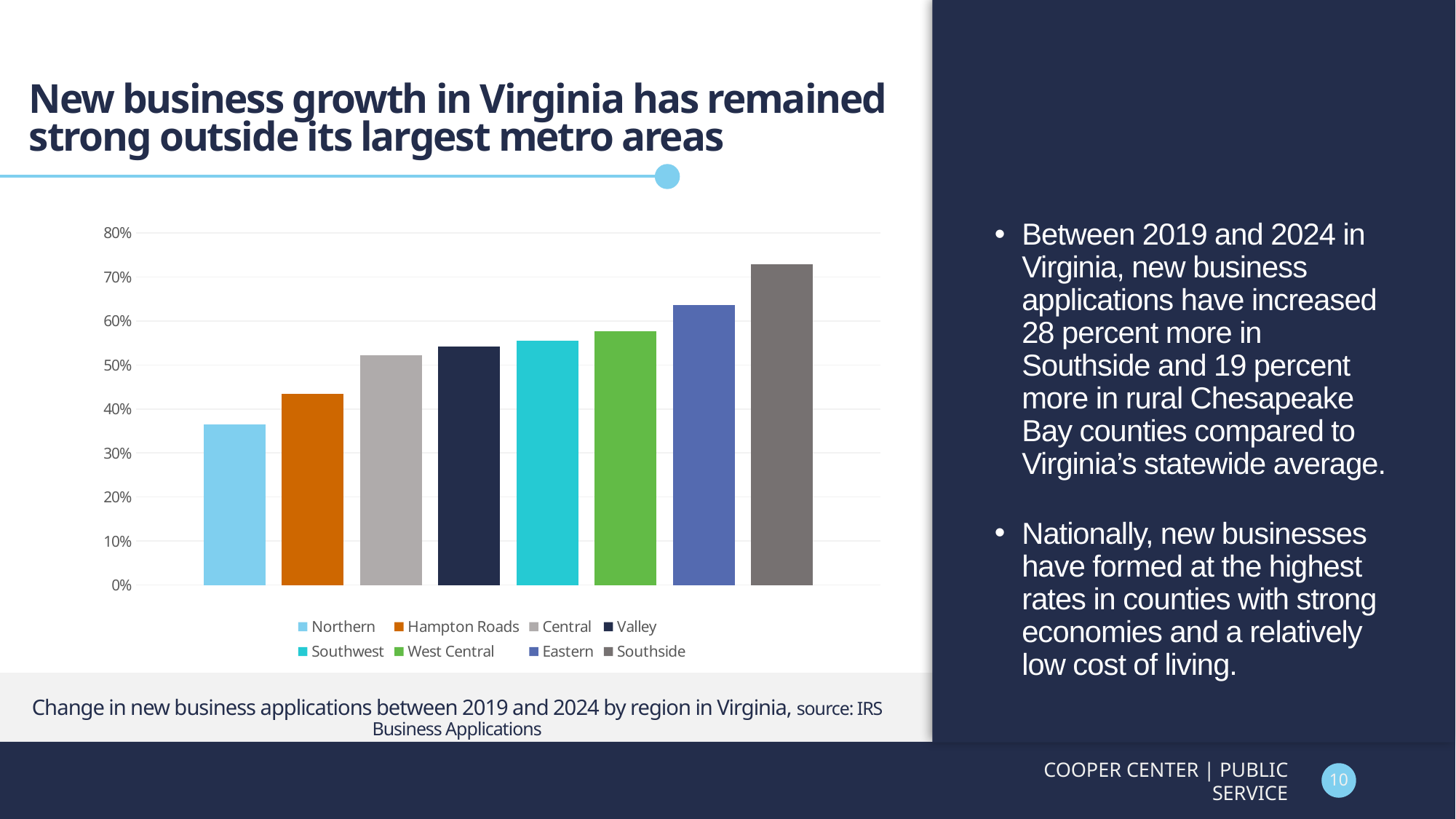
Do the bar values rise or fall moving from left to right across the chart? rise Which region has the lowest change in new business applications? Northern How many entries does the chart legend list? 8 Which is larger, the value for Eastern or the value for Hampton Roads? Eastern What colour is the bar for Hampton Roads? orange Is the value for Northern greater or less than 40%? less Is the value for Hampton Roads greater or less than 50%? less Is the value for Eastern greater or less than 60%? greater How many regions are plotted in the chart? 8 What kind of chart is shown on the slide? bar chart Which region has the highest change in new business applications? Southside